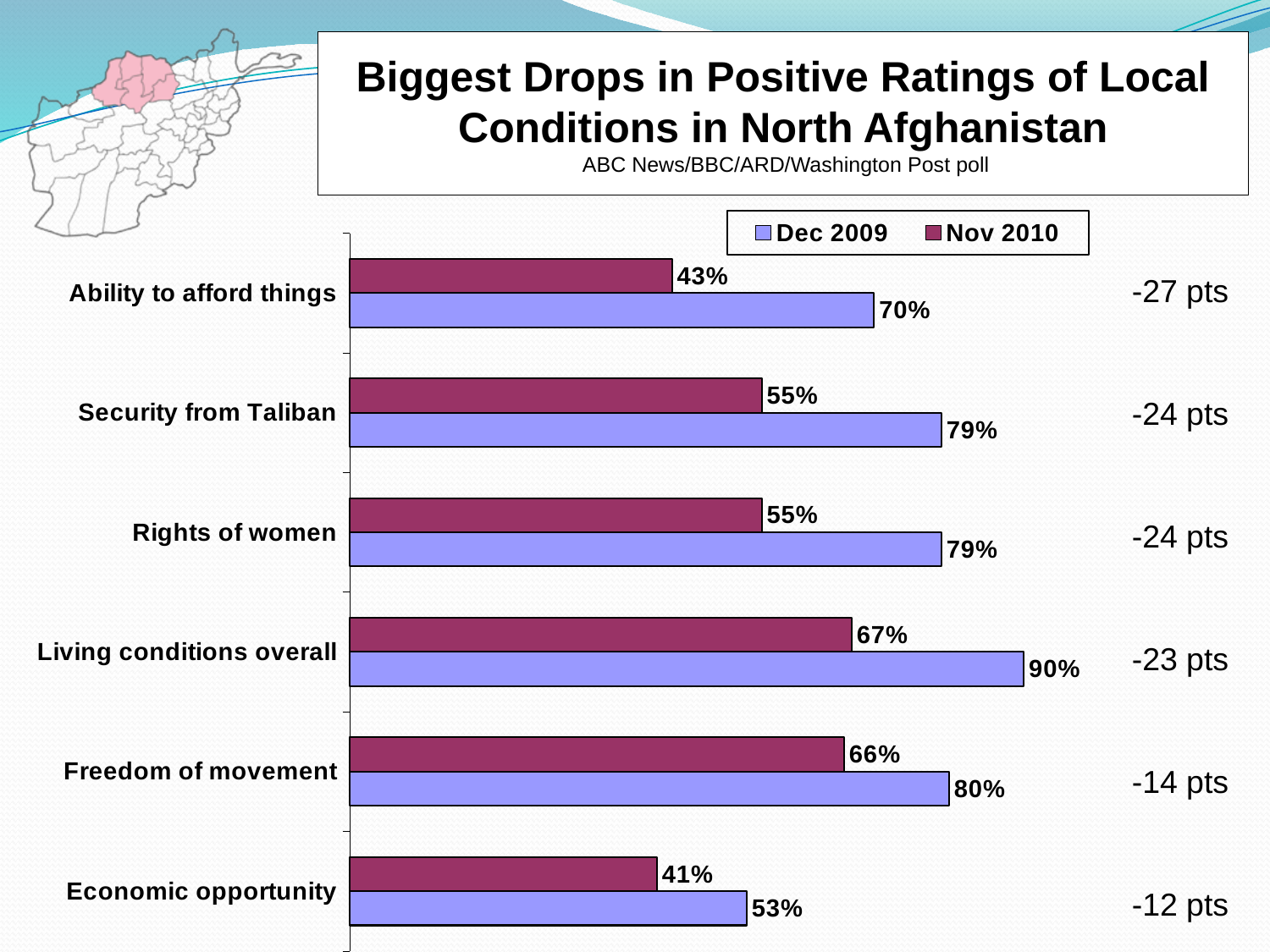
Which category shows the largest drop in points between Dec 2009 and Nov 2010? Ability to afford things Which is larger: the Nov 2010 value for Freedom of movement or the Nov 2010 value for Rights of women? Freedom of movement Which category has the highest Dec 2009 value? Living conditions overall What kind of chart is shown on the slide? Bar chart How many series does the legend list? 2 How many categories are shown in the chart? 6 Which series is shown in the darker (maroon) colour? Nov 2010 What is the Dec 2009 value for Living conditions overall? 90% What is the Nov 2010 value for Economic opportunity? 41% What is the Nov 2010 value for Ability to afford things? 43% Which category has the lowest Nov 2010 value? Economic opportunity What is the difference between the Dec 2009 and Nov 2010 values for Security from Taliban? 24 pts